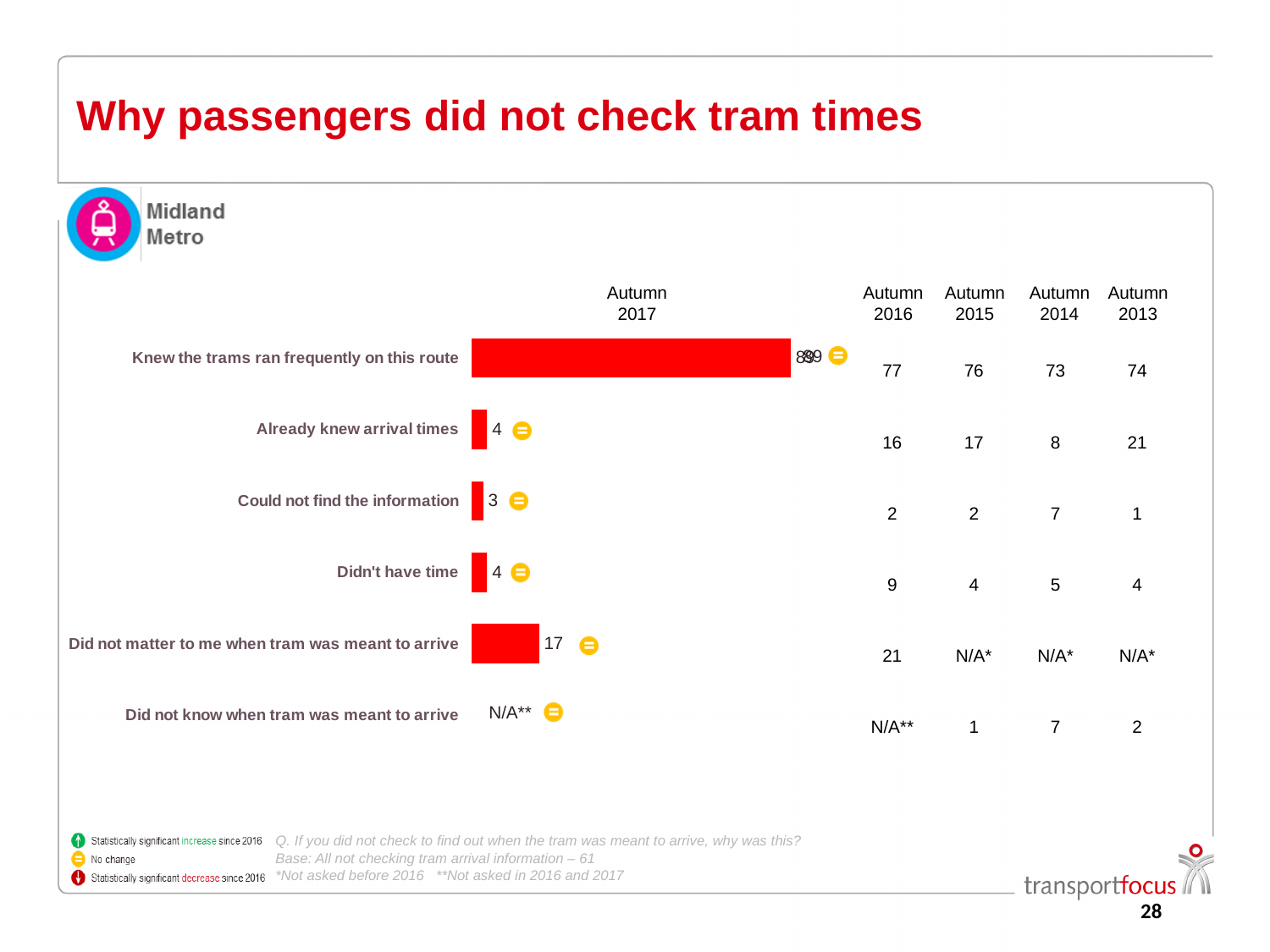
In the Autumn 2017 bar chart, what is the value for "Already knew arrival times"? 4 What kind of chart is shown on the slide? bar chart In the Autumn 2017 chart, which is larger: "Did not matter to me when tram was meant to arrive" or "Already knew arrival times"? Did not matter to me when tram was meant to arrive In the Autumn 2017 bar chart, what is the value for "Could not find the information"? 3 In the Autumn 2017 bar chart, what is shown for "Did not know when tram was meant to arrive"? N/A** How many categories are listed in the bar chart? 6 In the Autumn 2017 bar chart, what is the value for "Didn't have time"? 4 Which category has the longest bar in the Autumn 2017 chart? Knew the trams ran frequently on this route In the Autumn 2017 chart, what is the difference between "Did not matter to me when tram was meant to arrive" and "Didn't have time"? 13 Among the categories with a plotted bar in the Autumn 2017 chart, which has the lowest value? Could not find the information What colour are the bars in the chart? red In the Autumn 2017 bar chart, what is the value for "Did not matter to me when tram was meant to arrive"? 17